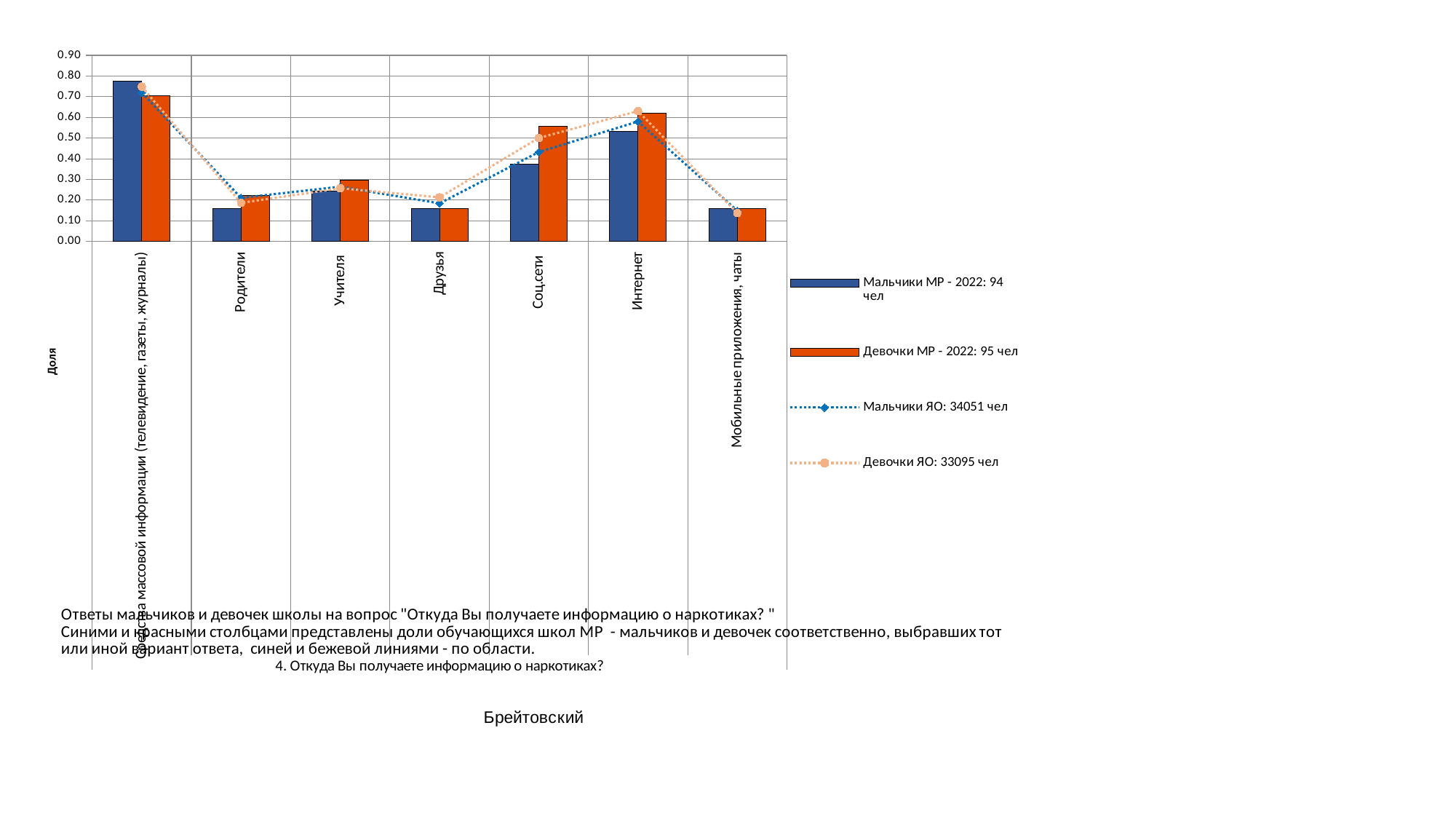
Is the value for 'Интернет' in the series 'Девочки МР - 2022: 95 чел' greater or less than 0.50? greater Is the value for 'Средства массовой информации' in the series 'Мальчики МР - 2022: 94 чел' greater or less than 0.70? greater How many answer categories are shown along the x axis of the chart? 7 Is the value for 'Соц.сети' in the series 'Мальчики МР - 2022: 94 чел' greater or less than 0.40? less Which category has the highest value for the series 'Девочки МР - 2022: 95 чел'? Средства массовой информации (телевидение, газеты, журналы) For 'Средства массовой информации', which bar is taller: 'Мальчики МР - 2022: 94 чел' or 'Девочки МР - 2022: 95 чел'? Мальчики МР - 2022: 94 чел What is the label of the vertical axis of the chart? Доля How many series does the chart legend list? 4 Which category has the highest value for the series 'Мальчики МР - 2022: 94 чел'? Средства массовой информации (телевидение, газеты, журналы) For 'Соц.сети', which bar is taller: 'Мальчики МР - 2022: 94 чел' or 'Девочки МР - 2022: 95 чел'? Девочки МР - 2022: 95 чел What kind of chart is shown on the slide? A combined bar and line chart